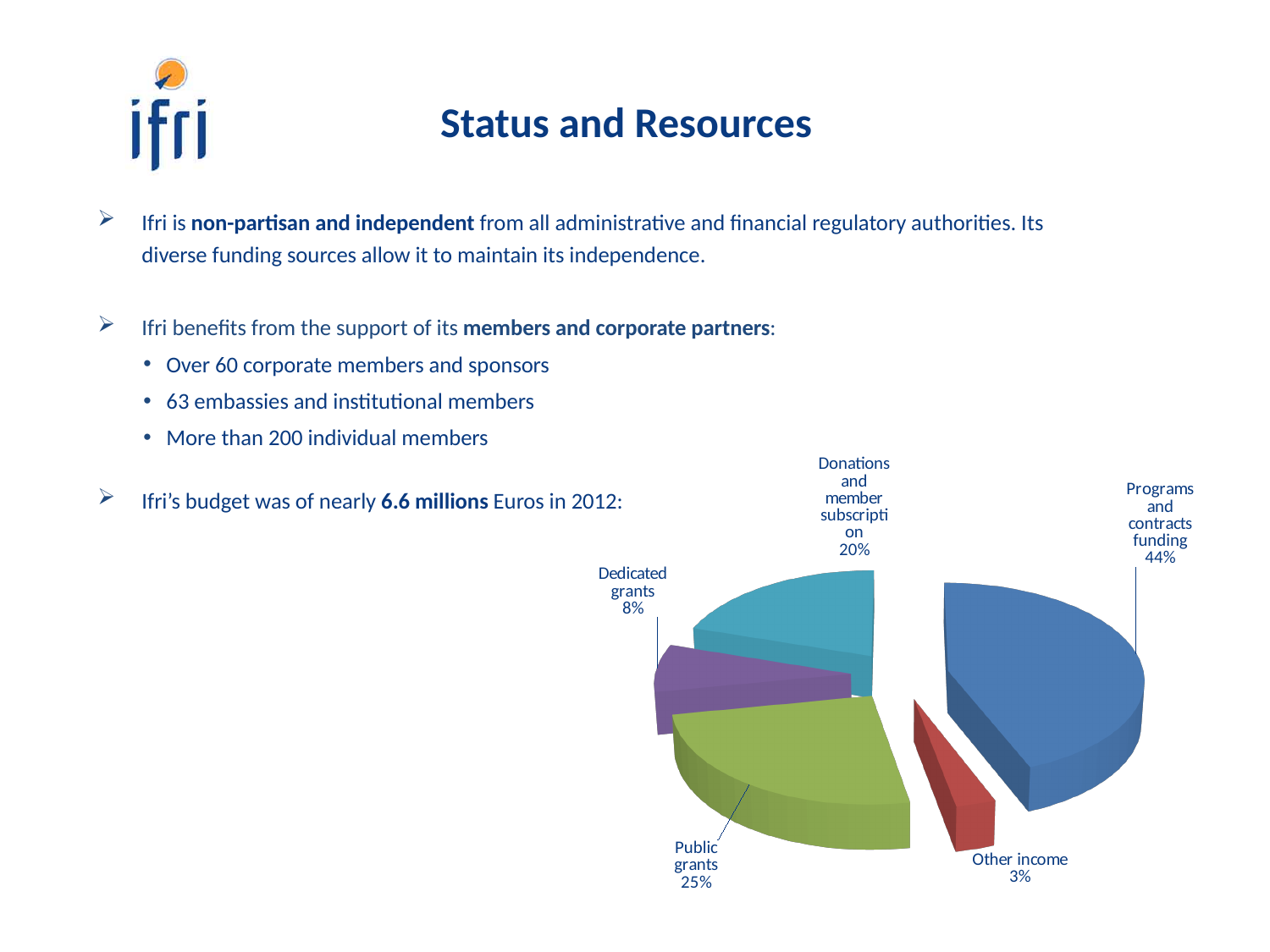
Which is larger, the share for Public grants or the share for Donations and member subscription? Public grants Which funding source has the largest share of the pie? Programs and contracts funding Which funding source has the smallest share of the pie? Other income What colour is the Public grants slice? Green What share of the budget comes from Programs and contracts funding? 44% What share of the budget comes from Other income? 3% How many slices does the pie chart have? 5 What share of the budget comes from Dedicated grants? 8% What share of the budget comes from Public grants? 25% What share of the budget comes from Donations and member subscription? 20% What is the difference in percentage points between Programs and contracts funding and Public grants? 19 percentage points What kind of chart is shown on the slide? Pie chart